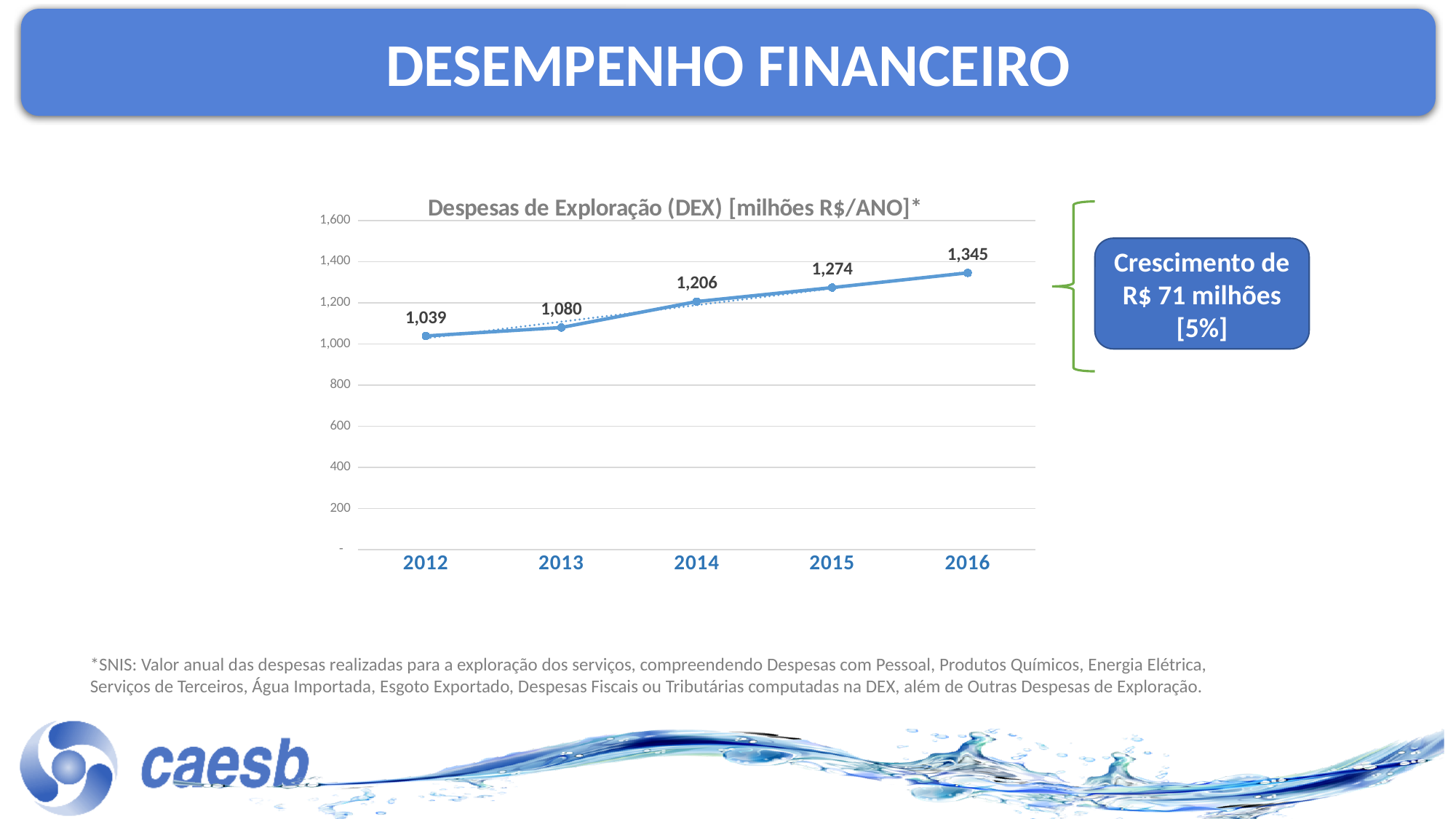
What is the value for 2014? 1,206 What is the title of the chart? Despesas de Exploração (DEX) [milhões R$/ANO]* Do the values rise or fall from 2012 to 2016? rise What is the value for 2012? 1,039 Which year has the highest value? 2016 How many years are plotted on the chart? 5 What is the value for 2016? 1,345 What is the difference between the values for 2016 and 2015? 71 Which year has the lowest value? 2012 Which is larger, the value for 2013 or the value for 2015? 2015 What is the difference between the values for 2013 and 2012? 41 What kind of chart is shown? line chart